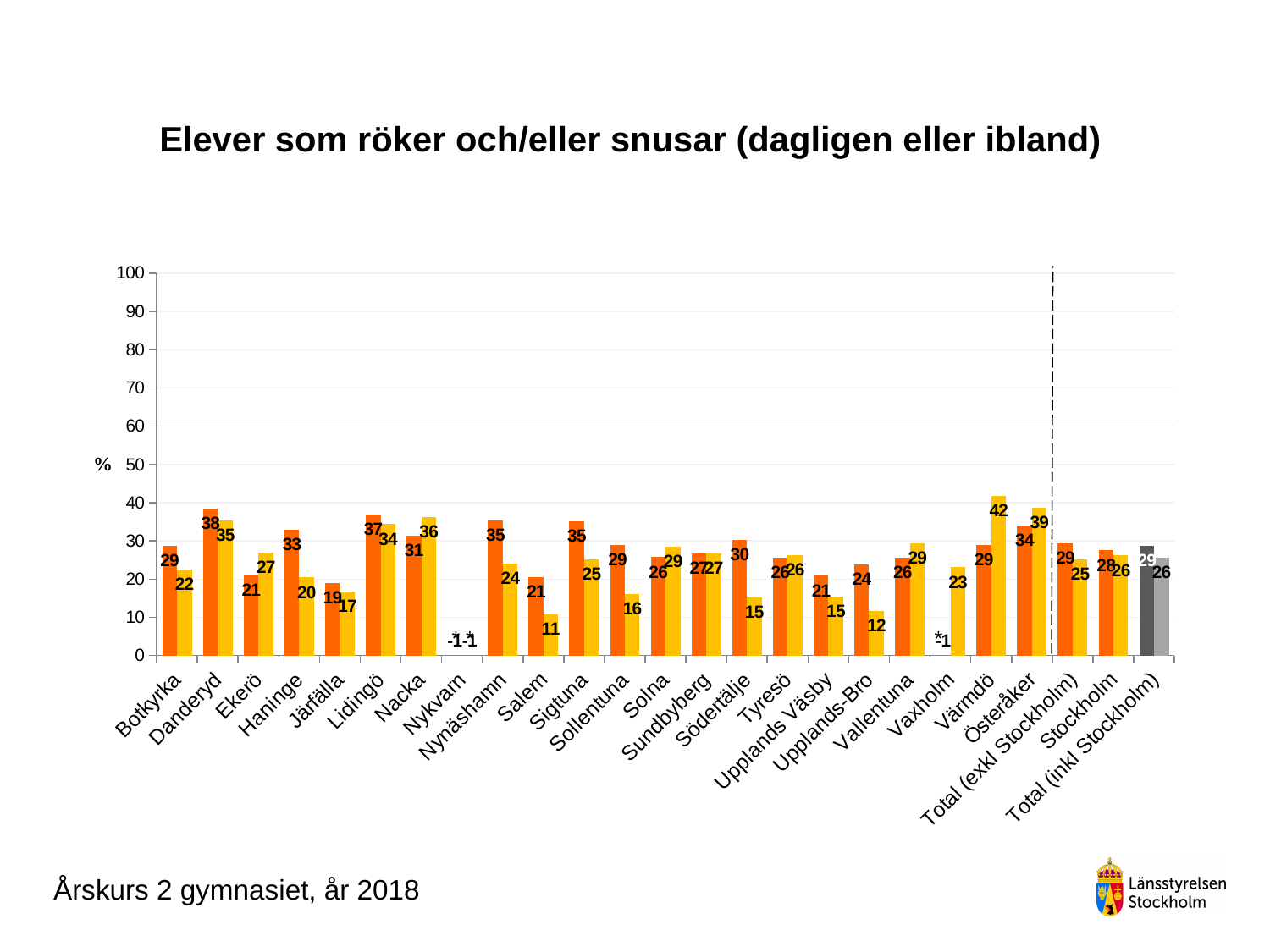
Is the value of the orange bar for Lidingö greater or less than 30? greater What is the value of the orange bar for Danderyd? 38 What is the value of the yellow bar for Salem? 11 Which category has the lowest yellow bar among those with a positive value? Salem What is the value of the yellow bar for Värmdö? 42 What is the title of the chart? Elever som röker och/eller snusar (dagligen eller ibland) What kind of chart is shown on the slide? bar chart What is the difference between the orange bar and the yellow bar for Södertälje? 15 Which category has the highest orange bar? Danderyd Which category has the highest yellow bar? Värmdö Which is larger for Nacka, the orange bar or the yellow bar? the yellow bar